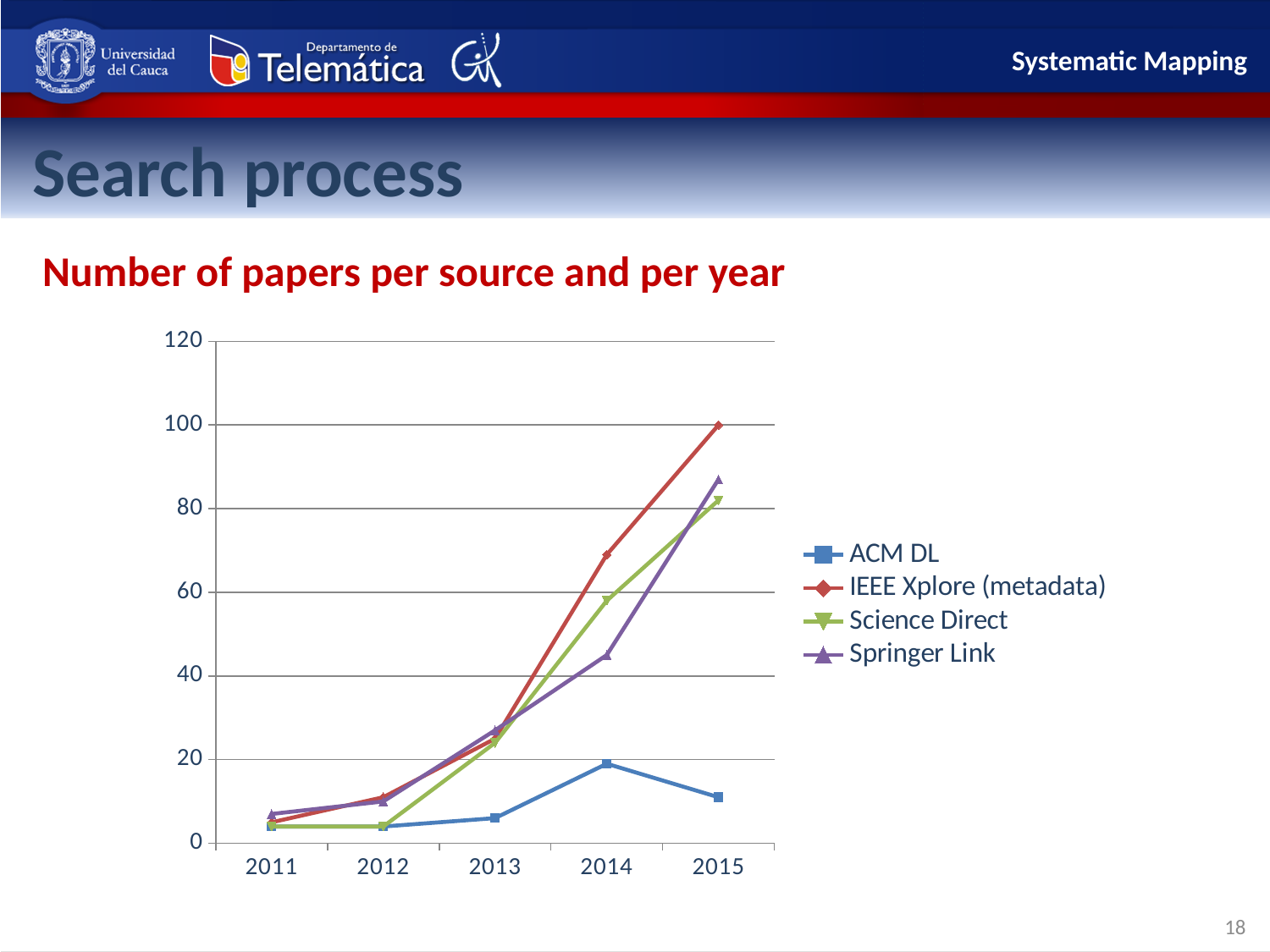
What is the title of the chart? Number of papers per source and per year How many years are shown on the x axis? 5 How many series does the legend list? 4 What kind of chart is shown on the slide? line chart Is the value for IEEE Xplore (metadata) in 2014 greater or less than 60? greater Which source has the highest number of papers in 2015? IEEE Xplore (metadata) Does the number of papers for IEEE Xplore (metadata) rise or fall from 2011 to 2015? rise Is the value for Science Direct in 2013 greater or less than 40? less Which is larger in 2014, Science Direct or Springer Link? Science Direct Which source has the lowest number of papers in 2015? ACM DL Is the value for Springer Link in 2015 greater or less than 80? greater